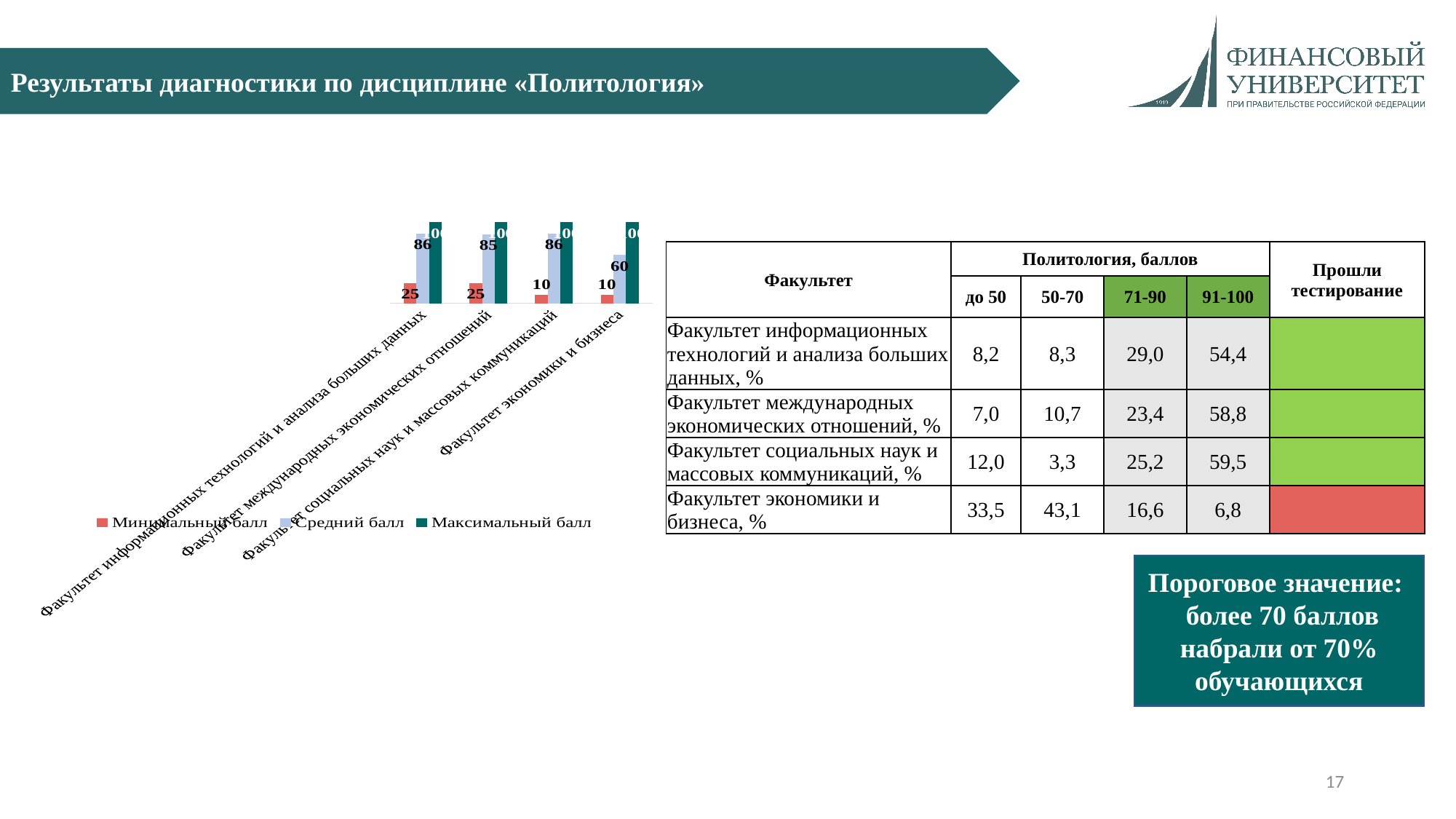
What are the three series named in the chart legend? Минимальный балл, Средний балл, Максимальный балл How many series does the chart legend list? 3 What kind of chart is shown on the slide? bar chart What is the Средний балл for Факультет международных экономических отношений on the chart? 85 Which has the larger Минимальный балл: Факультет информационных технологий и анализа больших данных or Факультет социальных наук и массовых коммуникаций? Факультет информационных технологий и анализа больших данных What is the Минимальный балл for Факультет экономики и бизнеса on the chart? 10 By how much does the Минимальный балл of Факультет информационных технологий и анализа больших данных exceed that of Факультет социальных наук и массовых коммуникаций? 15 How many faculties (categories) are plotted on the chart? 4 Which faculty has the lowest Средний балл on the chart? Факультет экономики и бизнеса What is the difference in Средний балл between Факультет информационных технологий и анализа больших данных and Факультет экономики и бизнеса? 26 What is the Минимальный балл for Факультет международных экономических отношений on the chart? 25 What is the Средний балл for Факультет экономики и бизнеса on the chart? 60